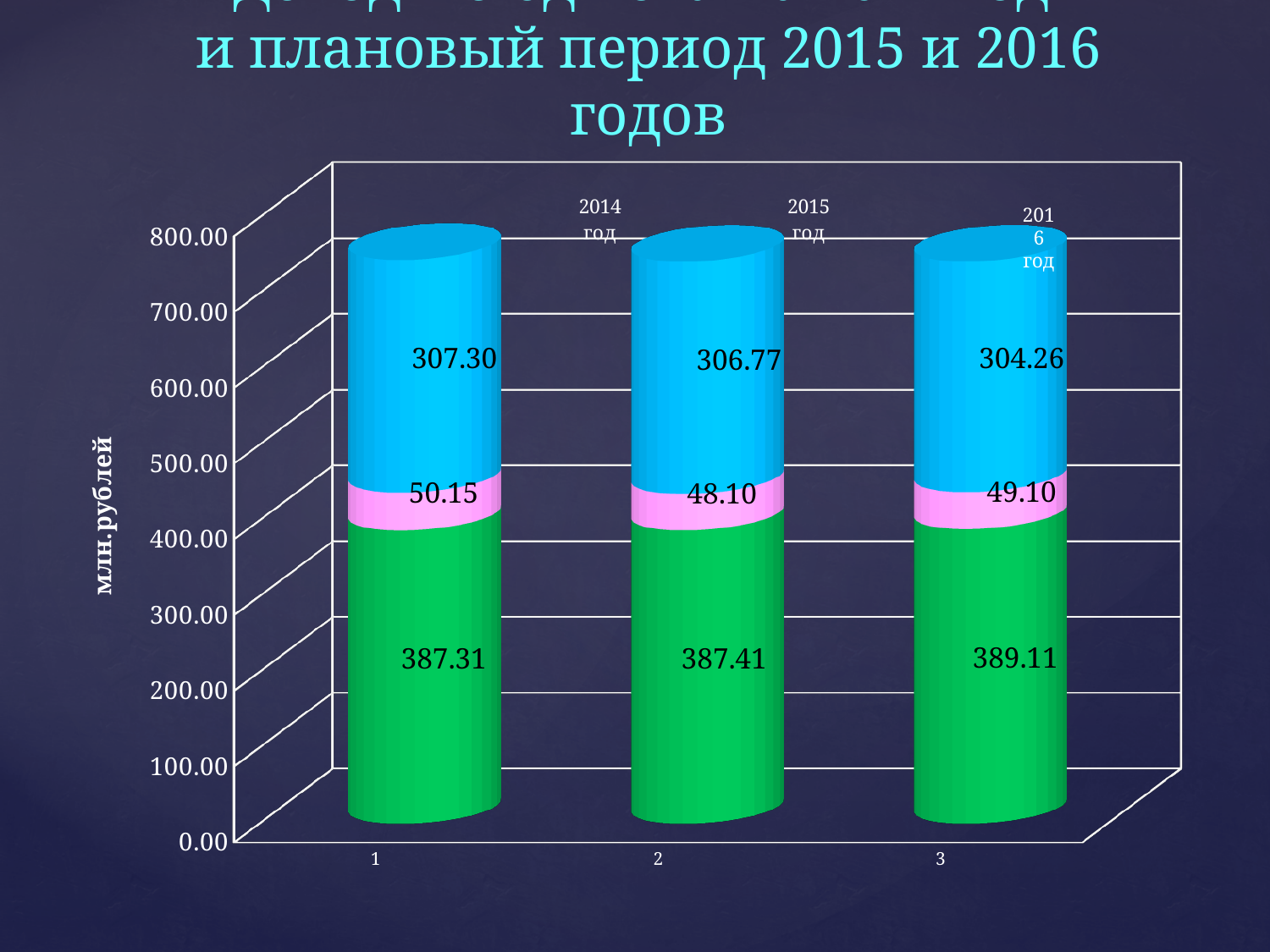
What is the total of the stacked bar for 2014 год? 744.76 How many bars are plotted in the chart? 3 What kind of chart is shown on the slide? stacked bar chart Which year has the highest value for the green segment? 2016 год What is the difference between the blue segment values for 2014 год and 2016 год? 3.04 Which year has the lowest value for the pink segment? 2015 год What is the value of the blue segment of the bar for 2016 год? 304.26 What is the label of the vertical axis? млн.рублей Which is larger, the pink segment for 2014 год or the pink segment for 2016 год? 2014 год What is the value of the pink segment of the bar for 2015 год? 48.10 Does the blue segment value for 2015 год rise or fall compared with 2014 год? fall What is the value of the green segment of the bar for 2014 год? 387.31